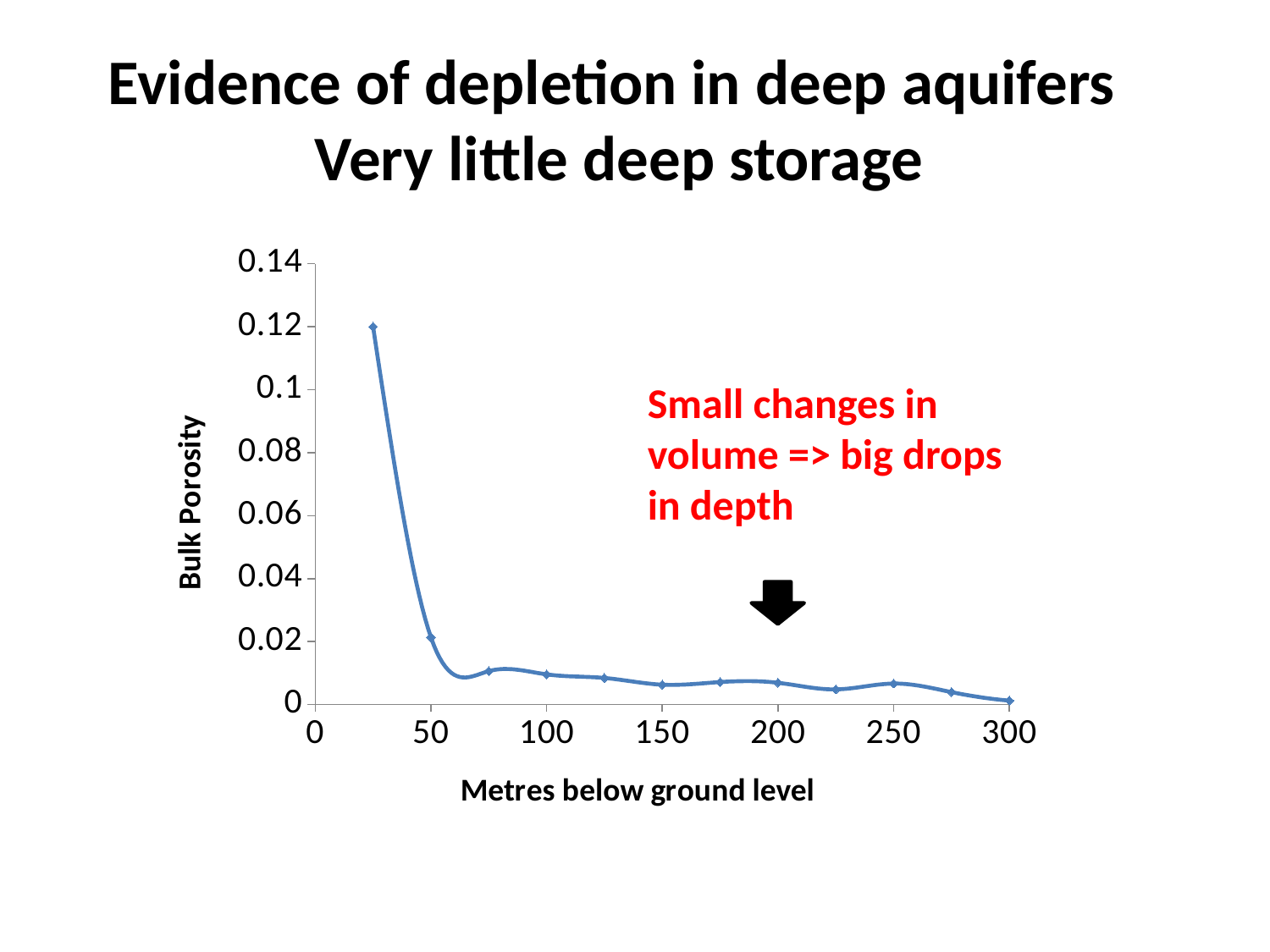
Is the bulk porosity at 25 metres below ground level greater or less than 0.1? greater Which depth has the higher bulk porosity, 50 or 100 metres below ground level? 50 At which depth (metres below ground level) is bulk porosity highest? 25 Is the bulk porosity at 50 metres below ground level greater or less than 0.04? less At which depth (metres below ground level) is bulk porosity lowest? 300 How many data points are plotted on the line? 12 Which depth has the higher bulk porosity, 25 or 50 metres below ground level? 25 What is the title of the x axis? Metres below ground level What is the title of the y axis? Bulk Porosity Is the bulk porosity at 100 metres below ground level greater or less than 0.02? less Does bulk porosity generally rise or fall as depth below ground level increases? fall What kind of chart is shown on the slide? line chart